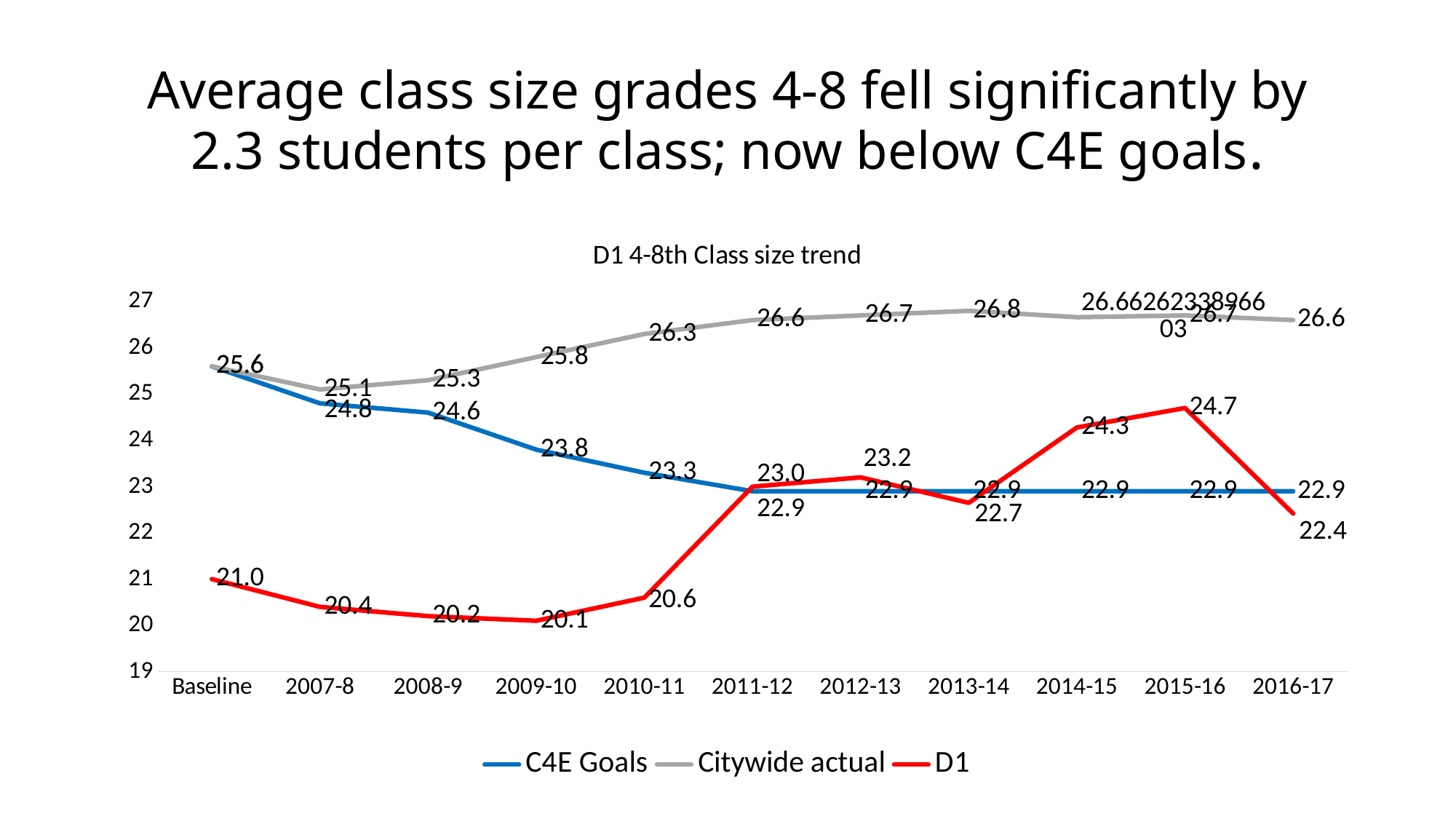
By how much did the D1 value fall from 2015-16 to 2016-17? 2.3 Do the C4E Goals values rise or fall from Baseline to 2011-12? fall In which year does the D1 series reach its highest value? 2015-16 What is the D1 value for 2010-11? 20.6 What is the Citywide actual value for 2013-14? 26.8 What colour is the D1 line in the legend? red What kind of chart is shown on the slide? line chart How many series does the legend list? 3 How many points are plotted along the x axis for each series? 11 In 2016-17, which is larger: the C4E Goals value or the D1 value? C4E Goals In which year does the D1 series reach its lowest value? 2009-10 What is the D1 value for 2015-16? 24.7